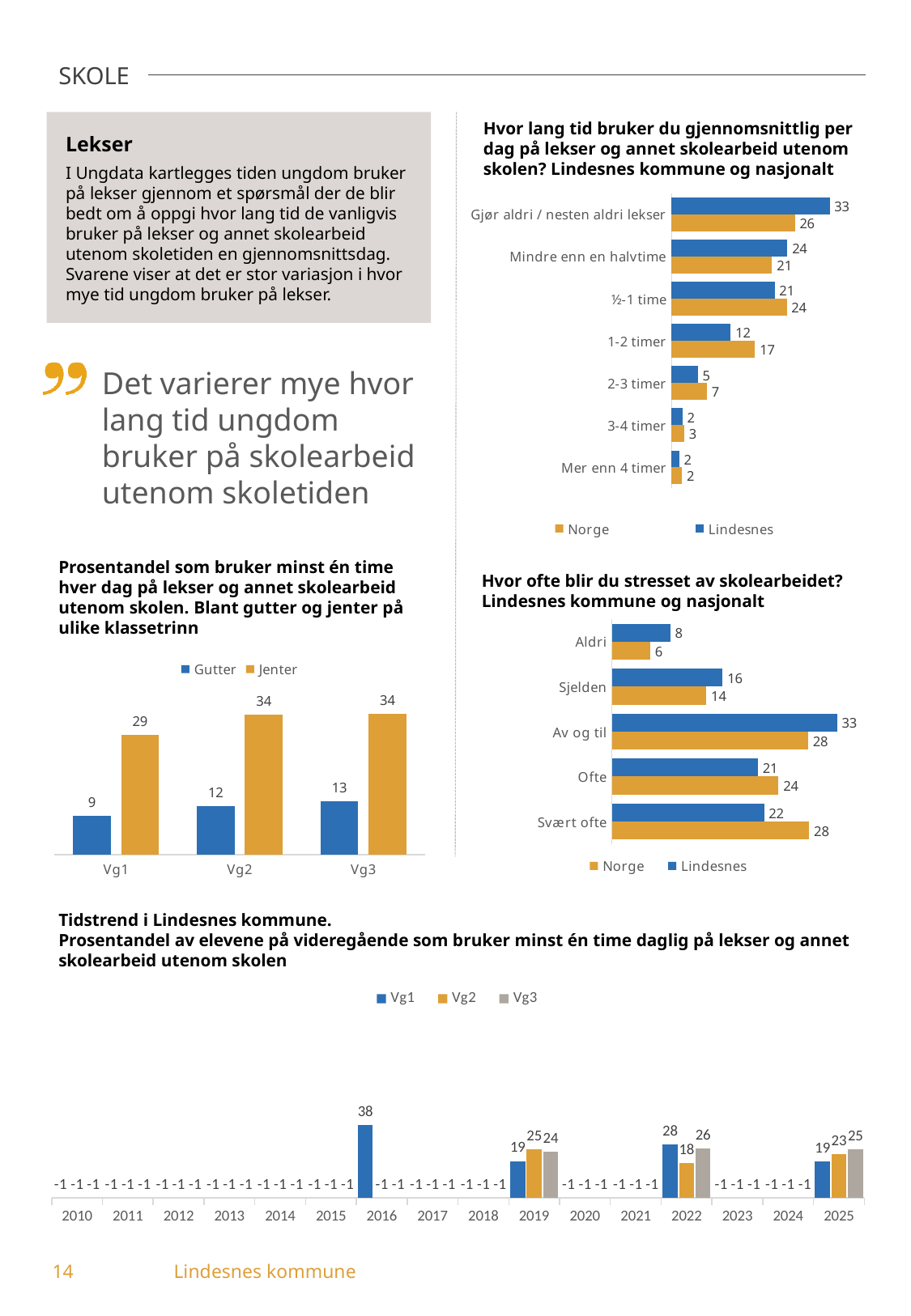
In the chart 'Prosentandel som bruker minst én time hver dag på lekser og annet skolearbeid utenom skolen', which class level has the lowest value for Gutter? Vg1 In the chart 'Hvor lang tid bruker du gjennomsnittlig per dag på lekser og annet skolearbeid utenom skolen?', what is the value for Lindesnes for 'Gjør aldri / nesten aldri lekser'? 33 In the chart 'Hvor lang tid bruker du gjennomsnittlig per dag på lekser og annet skolearbeid utenom skolen?', how many categories are shown on the vertical axis? 7 In the chart 'Hvor lang tid bruker du gjennomsnittlig per dag på lekser og annet skolearbeid utenom skolen?', what is the value for Norge for '1-2 timer'? 17 In the chart 'Hvor lang tid bruker du gjennomsnittlig per dag på lekser og annet skolearbeid utenom skolen?', what is the difference between Lindesnes and Norge for 'Gjør aldri / nesten aldri lekser'? 7 In the chart 'Tidstrend i Lindesnes kommune', what is the value for Vg1 in 2016? 38 In the chart 'Prosentandel som bruker minst én time hver dag på lekser og annet skolearbeid utenom skolen', what is the difference between Jenter and Gutter at Vg2? 22 In the chart 'Prosentandel som bruker minst én time hver dag på lekser og annet skolearbeid utenom skolen', what is the value for Jenter at Vg1? 29 In the chart 'Hvor ofte blir du stresset av skolearbeidet?', which is larger for 'Ofte': Norge or Lindesnes? Norge In the chart 'Tidstrend i Lindesnes kommune', how many series does the legend list? 3 In the chart 'Hvor ofte blir du stresset av skolearbeidet?', what is the value for Norge for 'Svært ofte'? 28 In the chart 'Hvor ofte blir du stresset av skolearbeidet?', which category has the highest value for Lindesnes? Av og til